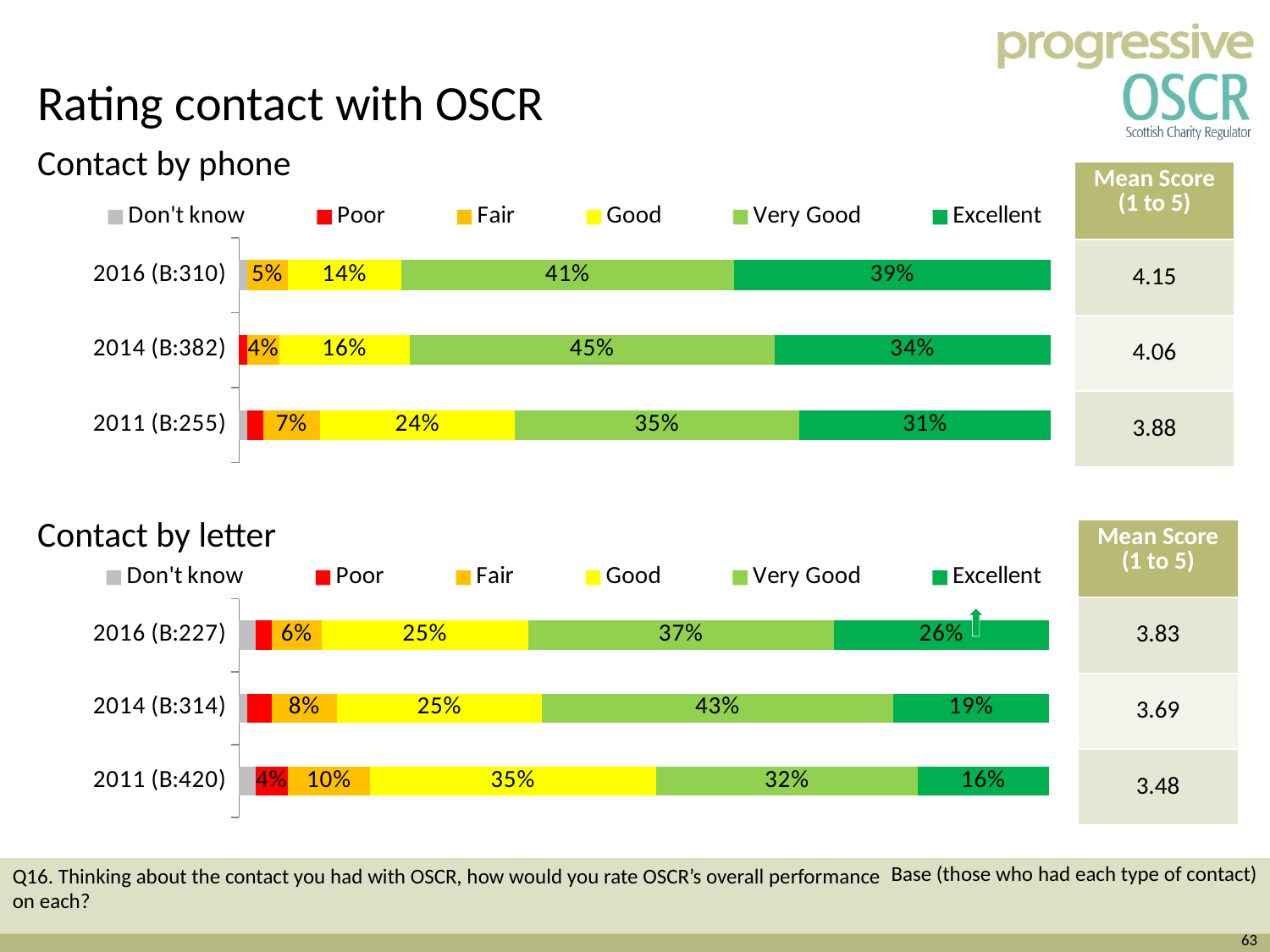
In the Contact by phone chart, what is the difference between the Good percentage in 2011 (B:255) and in 2016 (B:310)? 10% In the Contact by letter chart, is the Excellent percentage larger in 2016 (B:227) or in 2011 (B:420)? 2016 (B:227) In the Contact by phone chart, which year has the lowest Good percentage? 2016 (B:310) In the Contact by letter chart, which year has the highest Very Good percentage? 2014 (B:314) In the Contact by phone chart, what percentage rated contact as Excellent in 2016 (B:310)? 39% In the Contact by letter chart, what percentage rated contact as Excellent in 2014 (B:314)? 19% In the Contact by letter chart, how does the Excellent percentage change from 2011 to 2016? It rises In the Contact by phone chart, which year has the highest Excellent percentage? 2016 (B:310) In the Contact by phone chart, what percentage rated contact as Very Good in 2014 (B:382)? 45% What type of chart is the Contact by letter chart? Stacked bar chart In the Contact by letter chart, what percentage rated contact as Poor in 2011 (B:420)? 4% How many series does the legend of the Contact by phone chart list? 6